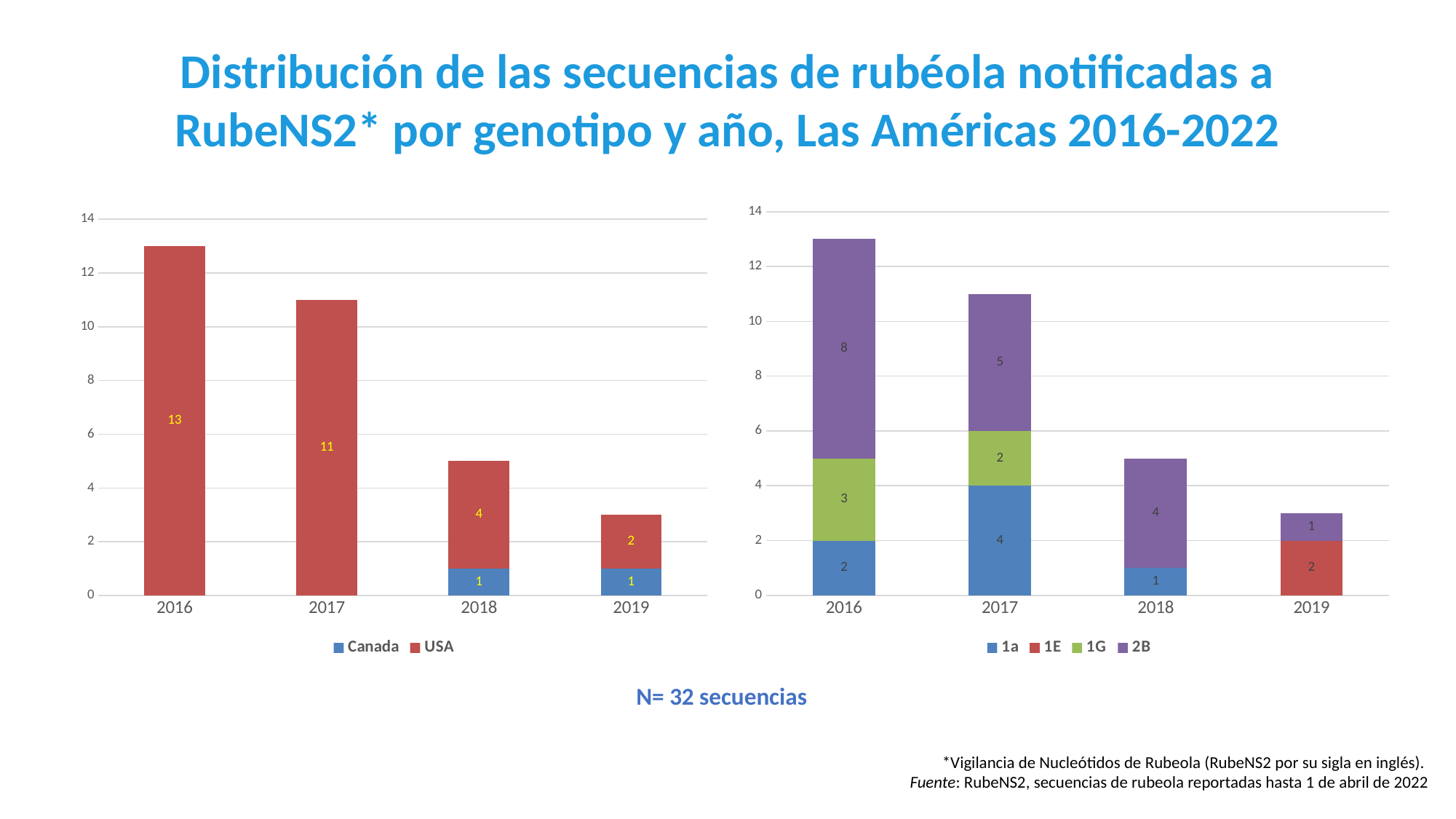
In the left chart (Canada/USA), what is the value for USA in 2016? 13 In the right chart (genotypes), what is the value for genotype 2B in 2016? 8 In the left chart (Canada/USA), what is the value for Canada in 2018? 1 What kind of chart is the right chart (genotypes)? Stacked bar chart In the left chart (Canada/USA), what is the difference between the USA values for 2017 and 2018? 7 In the right chart (genotypes), which is larger: the 1a value in 2017 or the 1a value in 2016? 1a in 2017 In the left chart (Canada/USA), what is the total of the stacked bar for 2019? 3 In the right chart (genotypes), what is the total of the stacked bar for 2017? 11 In the right chart (genotypes), what is the value for genotype 1G in 2017? 2 In the left chart (Canada/USA), how many series does the legend list? 2 In the left chart (Canada/USA), which year has the highest USA value? 2016 In the right chart (genotypes), how many series does the legend list? 4